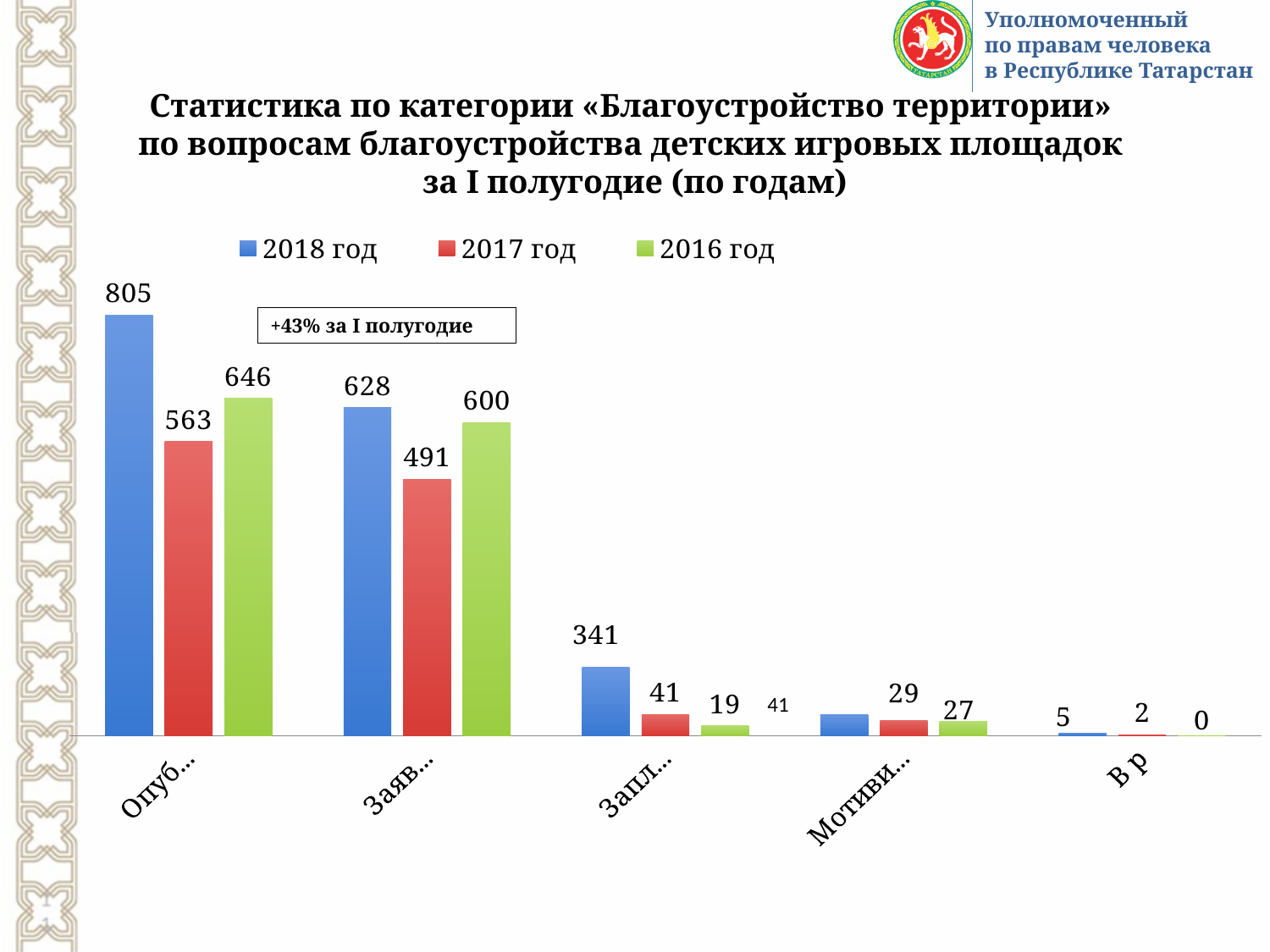
What is the difference between the 2018 год and 2017 год values in the second category group (Заяв...)? 137 What is the value of the 2017 год bar in the leftmost category group (Опуб...)? 563 In the second category group (Заяв...), which is larger: the 2018 год value or the 2016 год value? 2018 год What text is shown in the box above the bars? +43% за I полугодие How many category groups are plotted along the x axis? 5 How many series does the legend list? 3 What is the value of the 2016 год bar in the second category group (Заяв...)? 600 What is the value of the 2018 год bar in the leftmost category group (Опуб...)? 805 What kind of chart is shown on the slide? bar chart What is the value of the 2016 год bar in the rightmost category group? 0 What is the difference between the 2018 год and 2017 год values in the leftmost category group? 242 Which bar has the highest value on the chart? 2018 год in the leftmost group (805)